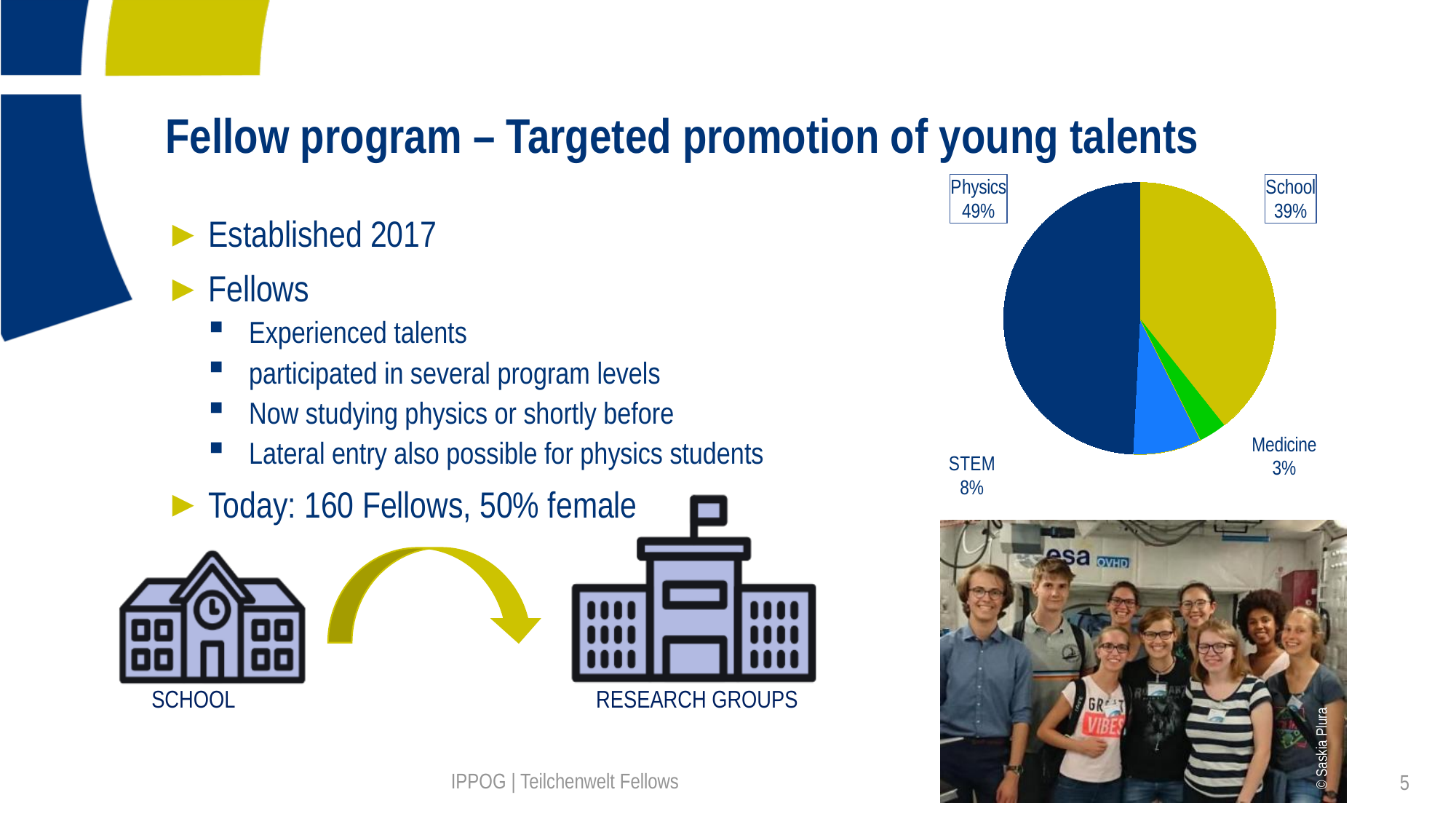
What is the difference in percentage points between the Physics and School slices? 10 How many slices does the pie chart have? 4 What kind of chart is shown on the slide? Pie chart What share of the pie chart does STEM represent? 8% What share of the pie chart does Medicine represent? 3% Which slice is larger, STEM or Medicine? STEM What colour is the Medicine slice in the pie chart? Green What share of the pie chart does Physics represent? 49% Which slice of the pie chart is the smallest? Medicine What colour is the School slice in the pie chart? Yellow Which slice of the pie chart is the largest? Physics What share of the pie chart does School represent? 39%